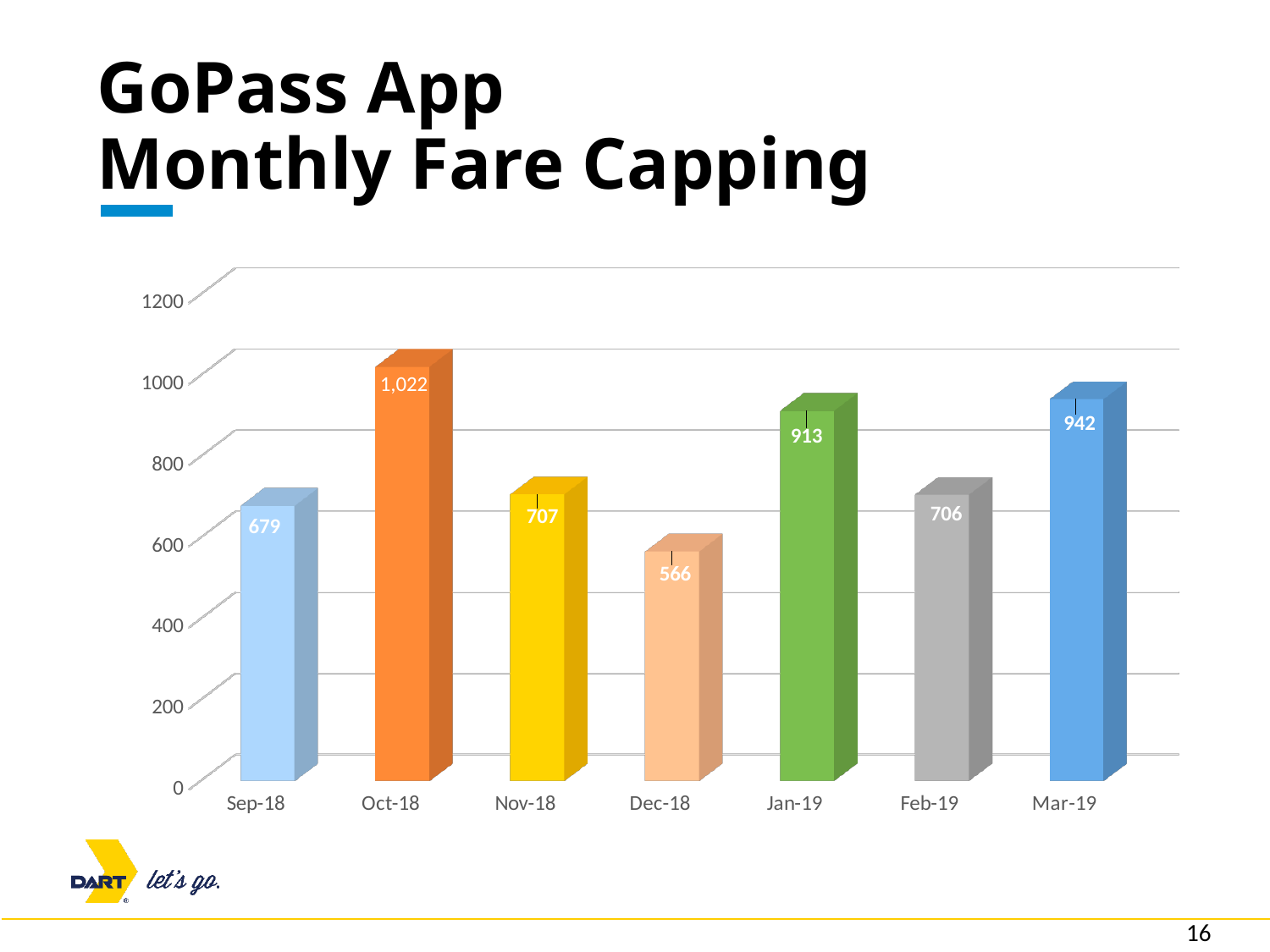
What is the value for Dec-18? 566 Which is larger, the value for Sep-18 or the value for Jan-19? Jan-19 What kind of chart is shown on the slide? bar chart What is the difference between the values for Mar-19 and Jan-19? 29 What is the value for Oct-18? 1,022 Is the value for Jan-19 greater or less than 800? greater What is the title of the slide? GoPass App Monthly Fare Capping Which month has the highest value? Oct-18 How many months are shown on the x axis? 7 Which month has the lowest value? Dec-18 What is the difference between the values for Oct-18 and Dec-18? 456 What is the value for Mar-19? 942